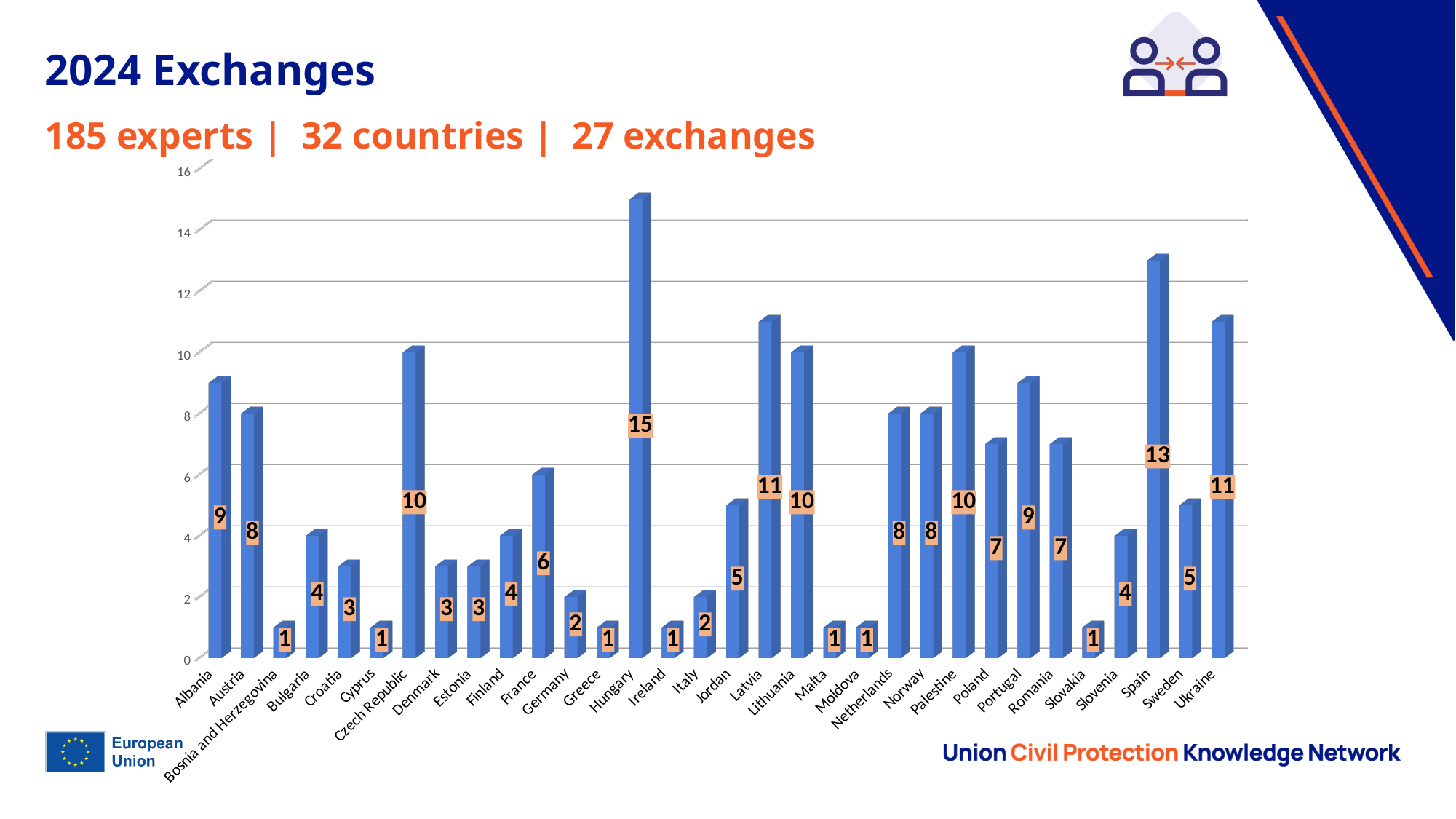
How many countries are shown on the x axis? 32 Which is larger, the value for Latvia or the value for Lithuania? Latvia What is the difference between the values for Hungary and Spain? 2 What is the value for Bosnia and Herzegovina? 1 What is the value for Spain? 13 What kind of chart is shown on the slide? Bar chart Which country has the highest value? Hungary Which is larger, the value for France or the value for Portugal? Portugal What is the value for Czech Republic? 10 What is the title of the slide? 2024 Exchanges What is the difference between the values for Ukraine and Jordan? 6 What is the value for Hungary? 15